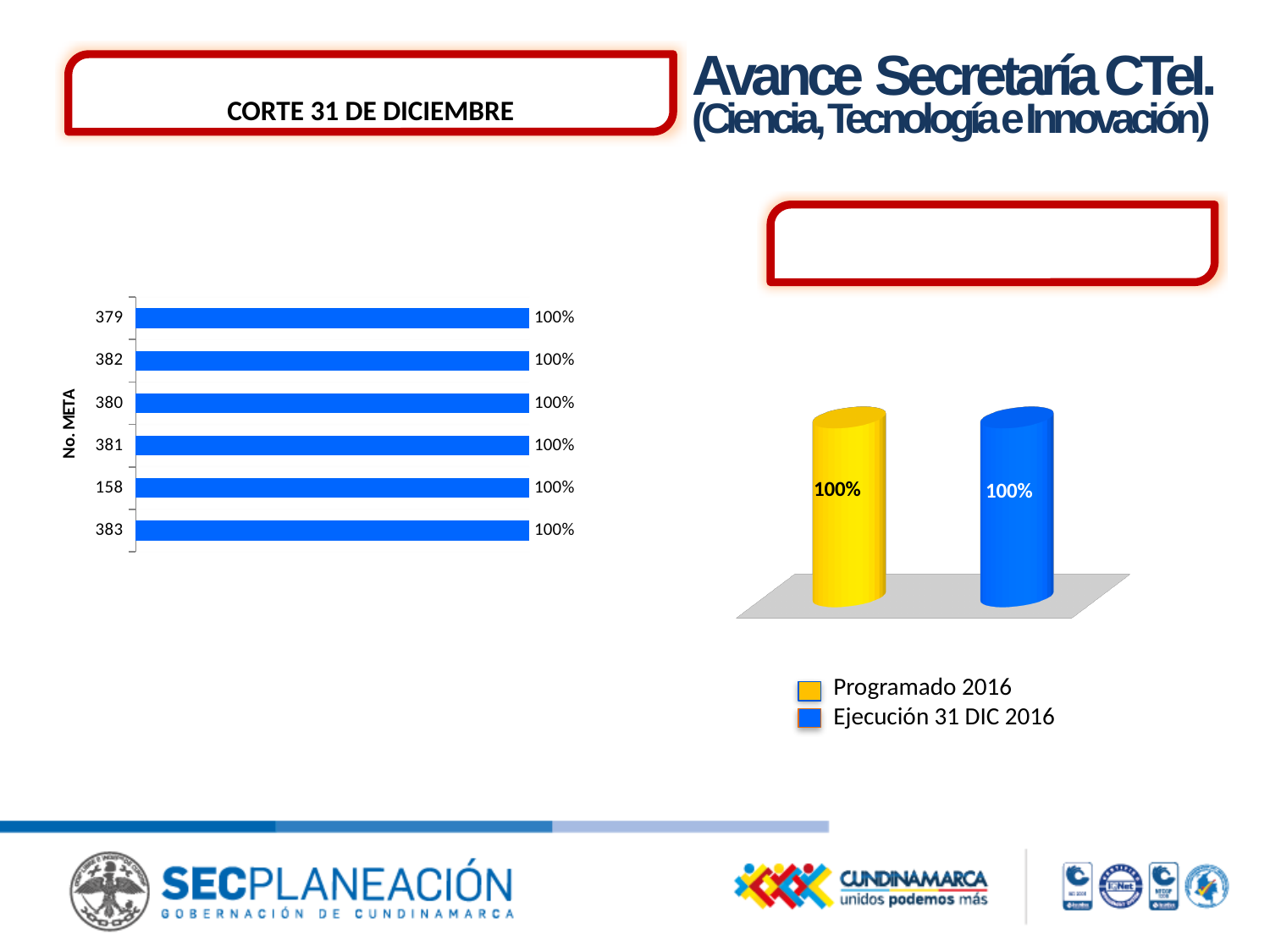
In the left chart, what is the value for meta 158? 100% What kind of chart is the left chart? Bar chart In the right chart, what is the value for Ejecución 31 DIC 2016? 100% In the right chart, what is the difference between Programado 2016 and Ejecución 31 DIC 2016? 0% In the right chart, what colour is the bar for Programado 2016? Yellow What is the label on the vertical axis of the left chart? No. META In the left chart, what is the value for meta 383? 100% In the left chart, what is the difference between the values for meta 382 and meta 381? 0% In the right chart, what is the value for Programado 2016? 100% How many bars (metas) are shown in the left chart? 6 How many entries does the legend of the right chart list? 2 In the left chart, what is the value for meta 379? 100%